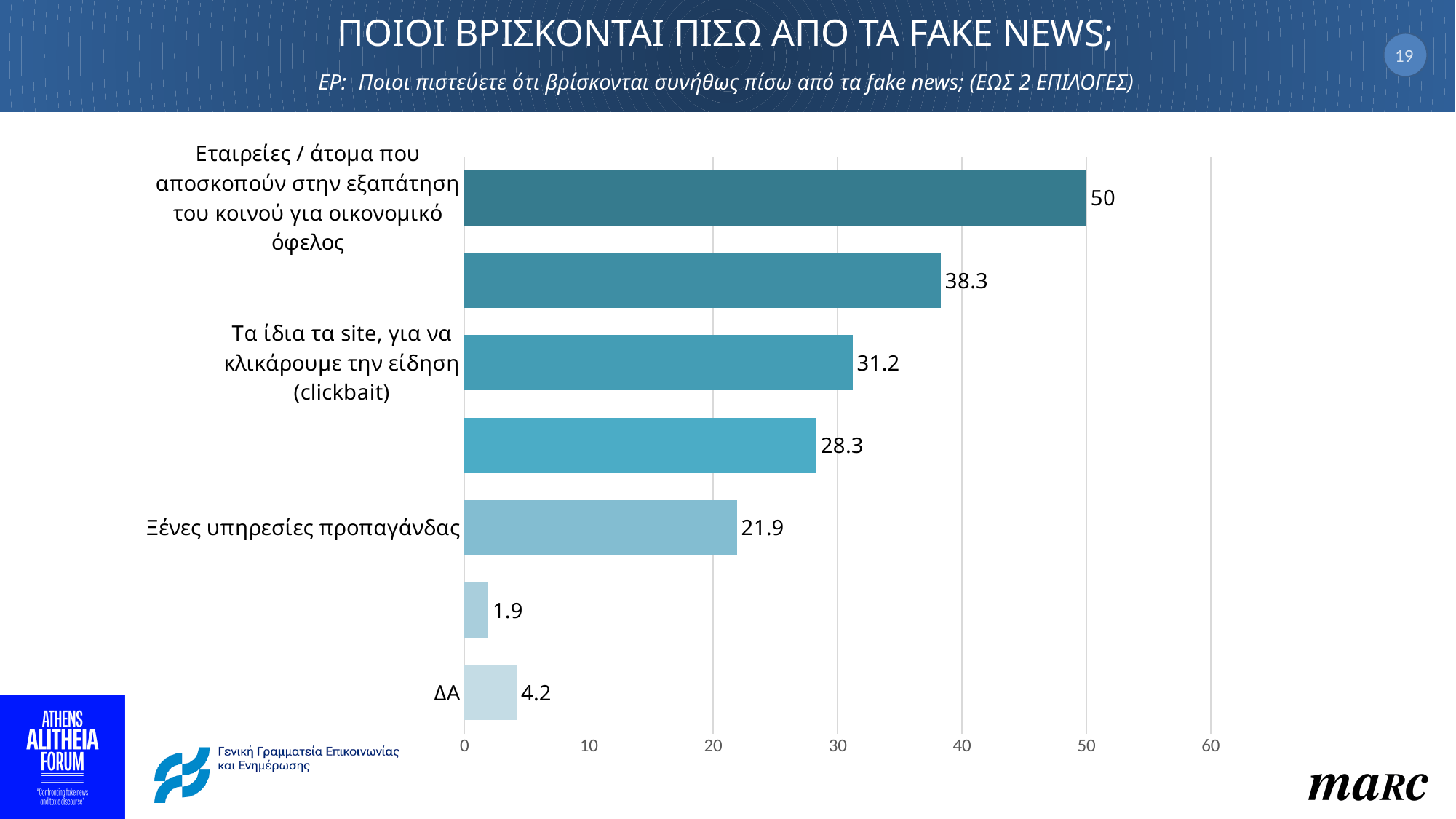
What type of chart is shown on the slide? bar chart What is the value for 'Τα ίδια τα site, για να κλικάρουμε την είδηση (clickbait)'? 31.2 What is the smallest value shown on any bar in the chart? 1.9 Which is larger: the value for 'Τα ίδια τα site, για να κλικάρουμε την είδηση (clickbait)' or the value for 'Ξένες υπηρεσίες προπαγάνδας'? Τα ίδια τα site, για να κλικάρουμε την είδηση (clickbait) What is the value for 'ΔΑ'? 4.2 What is the difference between the value for 'Εταιρείες / άτομα που αποσκοπούν στην εξαπάτηση του κοινού για οικονομικό όφελος' and the value for 'Τα ίδια τα site, για να κλικάρουμε την είδηση (clickbait)'? 18.8 Is the value for 'Ξένες υπηρεσίες προπαγάνδας' greater or less than 30? less Which category has the highest value in the chart? Εταιρείες / άτομα που αποσκοπούν στην εξαπάτηση του κοινού για οικονομικό όφελος What is the value for 'Εταιρείες / άτομα που αποσκοπούν στην εξαπάτηση του κοινού για οικονομικό όφελος'? 50 What is the difference between the value for 'Ξένες υπηρεσίες προπαγάνδας' and the value for 'ΔΑ'? 17.7 How many bars are plotted in the chart? 7 What is the value for 'Ξένες υπηρεσίες προπαγάνδας'? 21.9